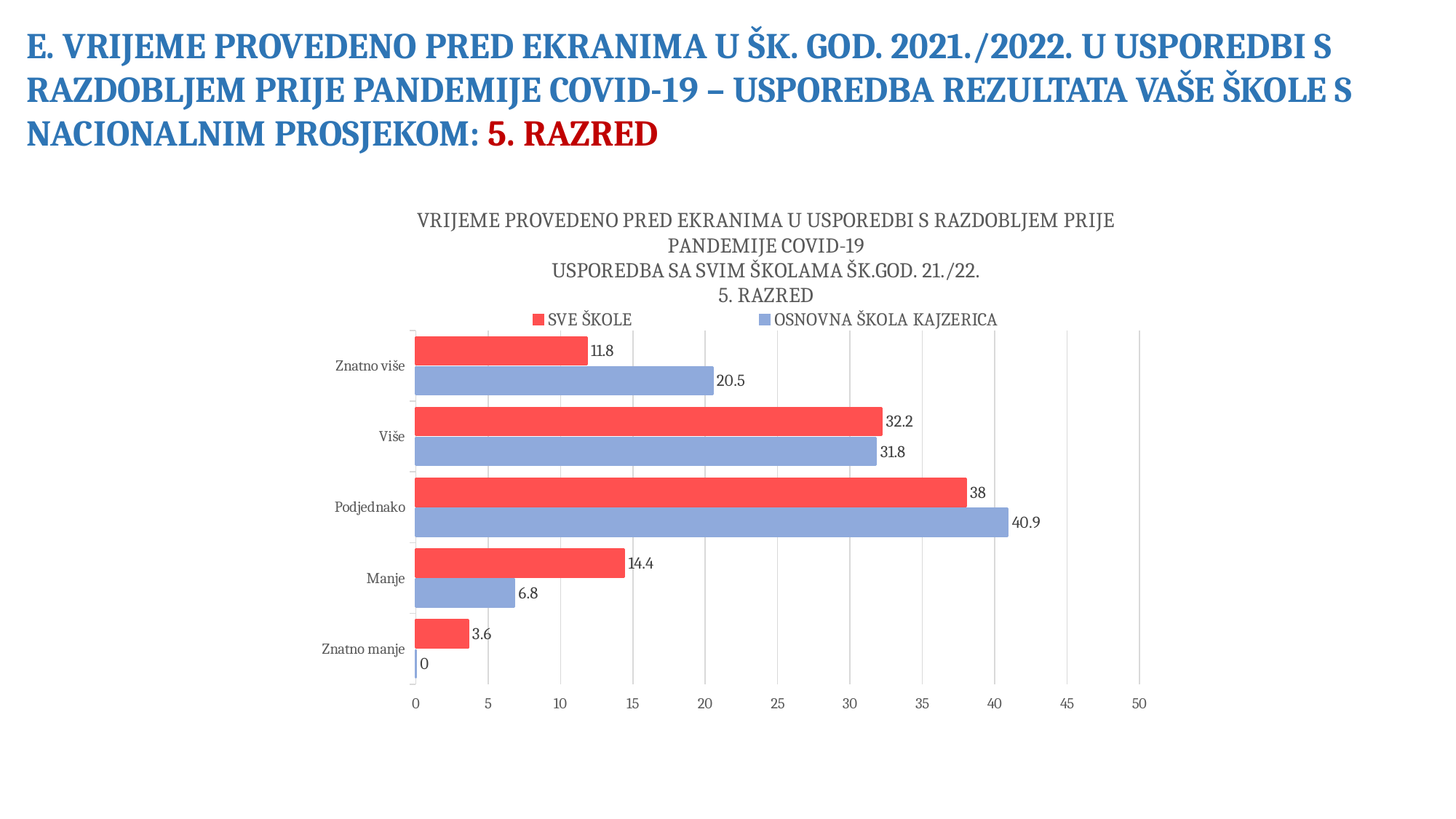
In the Više category, which series has the larger value, SVE ŠKOLE or OSNOVNA ŠKOLA KAJZERICA? SVE ŠKOLE Which category has the lowest value for SVE ŠKOLE? Znatno manje What is the value for SVE ŠKOLE in the Podjednako category? 38 Which category has the highest value for OSNOVNA ŠKOLA KAJZERICA? Podjednako What is the difference between the OSNOVNA ŠKOLA KAJZERICA and SVE ŠKOLE values in the Znatno više category? 8.7 What is the difference between the SVE ŠKOLE and OSNOVNA ŠKOLA KAJZERICA values in the Manje category? 7.6 What is the value for OSNOVNA ŠKOLA KAJZERICA in the Znatno više category? 20.5 What kind of chart is shown on the slide? Bar chart What is the value for OSNOVNA ŠKOLA KAJZERICA in the Znatno manje category? 0 Is the value for OSNOVNA ŠKOLA KAJZERICA in the Podjednako category greater or less than 40? greater How many series does the legend list? 2 How many categories are shown on the chart? 5